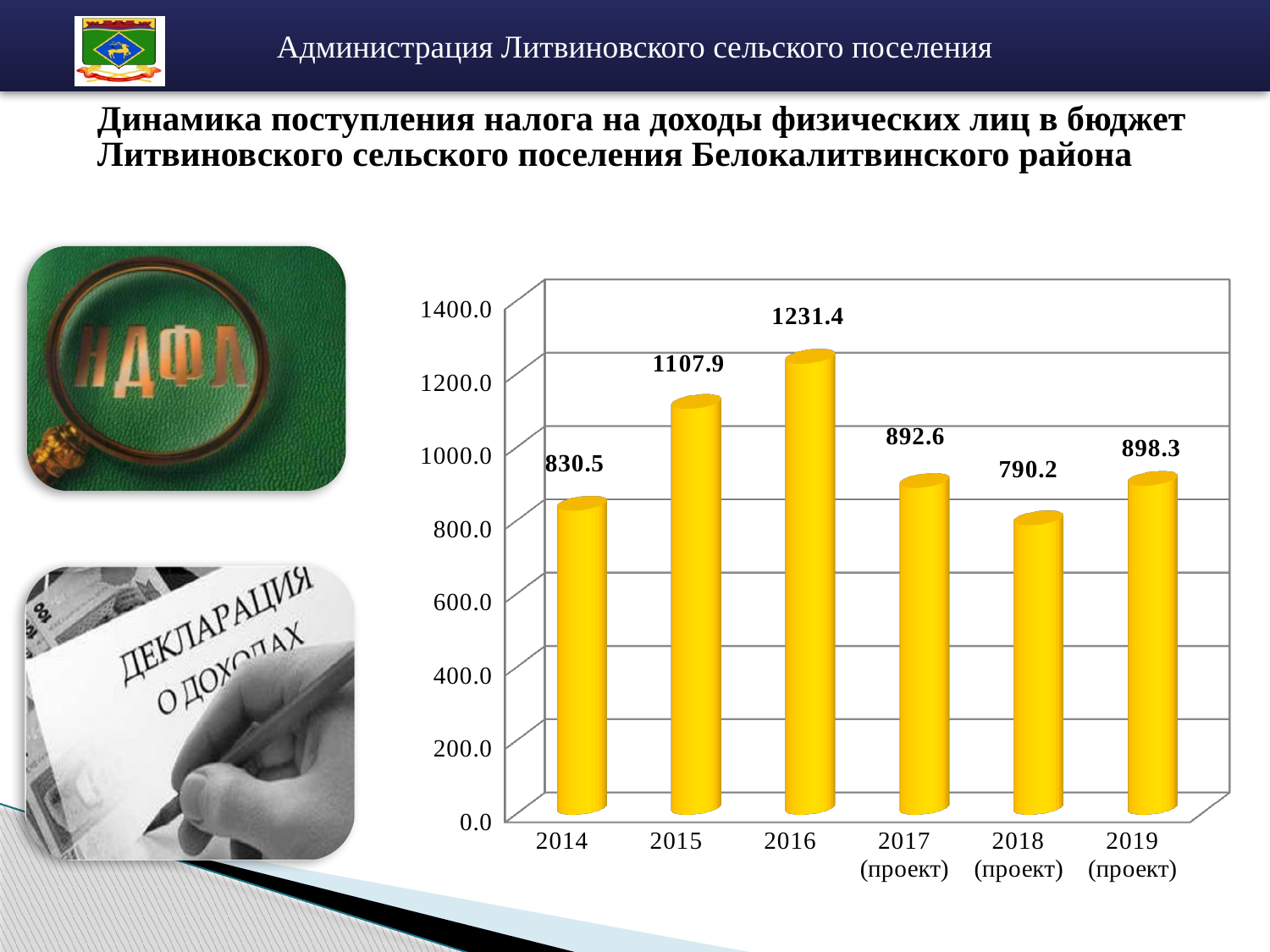
What is the value for 2018 (проект)? 790.2 What is the difference between the values for 2019 (проект) and 2018 (проект)? 108.1 How many years are shown on the x axis? 6 Is the value for 2015 greater or less than 1000.0? greater Which year has the lowest value? 2018 (проект) Which year has the highest value? 2016 What is the difference between the values for 2016 and 2015? 123.5 Which is larger, the value for 2017 (проект) or the value for 2019 (проект)? 2019 (проект) What is the value for 2016? 1231.4 Do the values rise or fall from 2014 to 2016? rise What kind of chart is shown on the slide? bar chart What is the value for 2014? 830.5